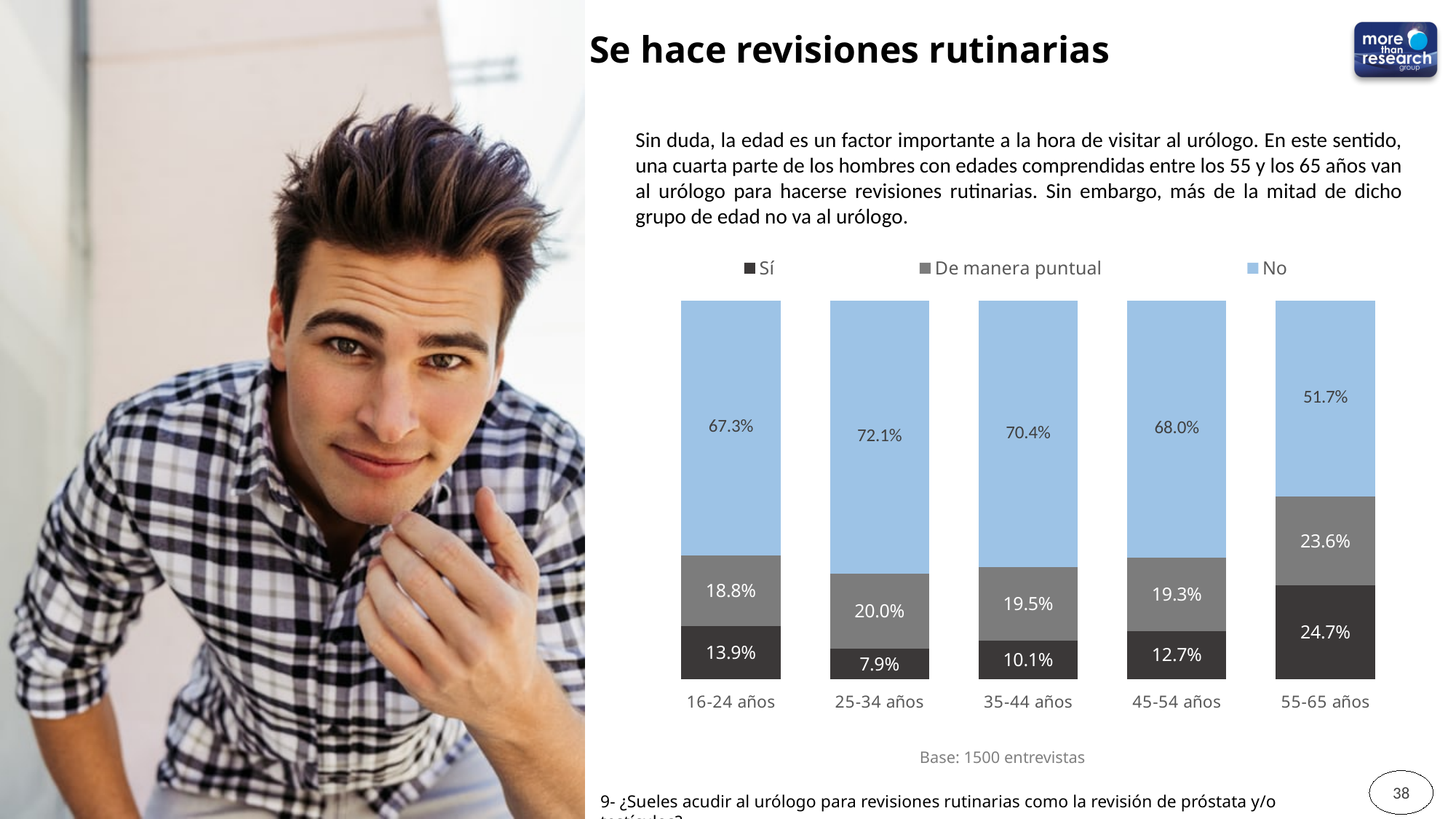
What is the value of 'De manera puntual' for the 45-54 años group? 19.3% How many age groups are shown on the x axis of the chart? 5 Which age group has the highest value for 'Sí'? 55-65 años What type of chart is shown on the slide? Stacked bar chart Which age group has the lowest value for 'Sí'? 25-34 años What is the value of 'No' for the 25-34 años group? 72.1% What is the difference between the 'No' value for 25-34 años and the 'No' value for 55-65 años? 20.4 percentage points Which is larger: the 'Sí' value for 16-24 años or for 45-54 años? 16-24 años Which age group has the lowest value for 'No'? 55-65 años How many series does the chart legend list? 3 What are the three legend entries of the chart? Sí, De manera puntual, No What is the value of 'Sí' for the 55-65 años group? 24.7%